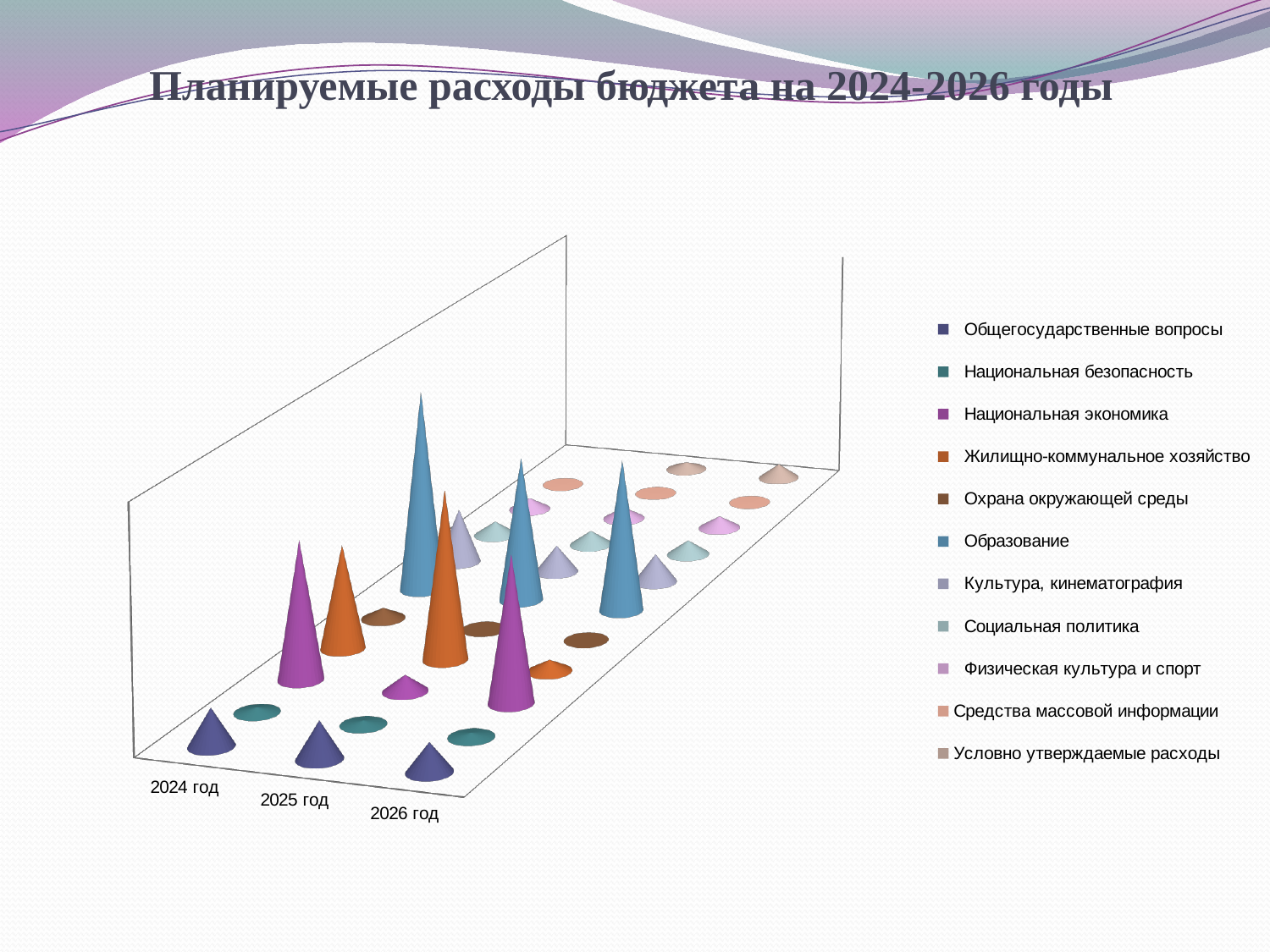
Which years are shown as categories on the chart? 2024 год, 2025 год, 2026 год For 2024 год, which is larger: Жилищно-коммунальное хозяйство or Охрана окружающей среды? Жилищно-коммунальное хозяйство Which series has the tallest cone for 2024 год? Образование For 2024 год, which is larger: Национальная экономика or Общегосударственные вопросы? Национальная экономика For 2025 год, which is larger: Образование or Жилищно-коммунальное хозяйство? Жилищно-коммунальное хозяйство How many year categories are shown along the x axis of the chart? 3 Which series has the tallest cone for 2026 год? Образование How many series does the chart's legend list? 11 What is the title of the slide's chart? Планируемые расходы бюджета на 2024-2026 годы Which series has the tallest cone for 2025 год? Жилищно-коммунальное хозяйство What kind of chart is shown on the slide? bar chart